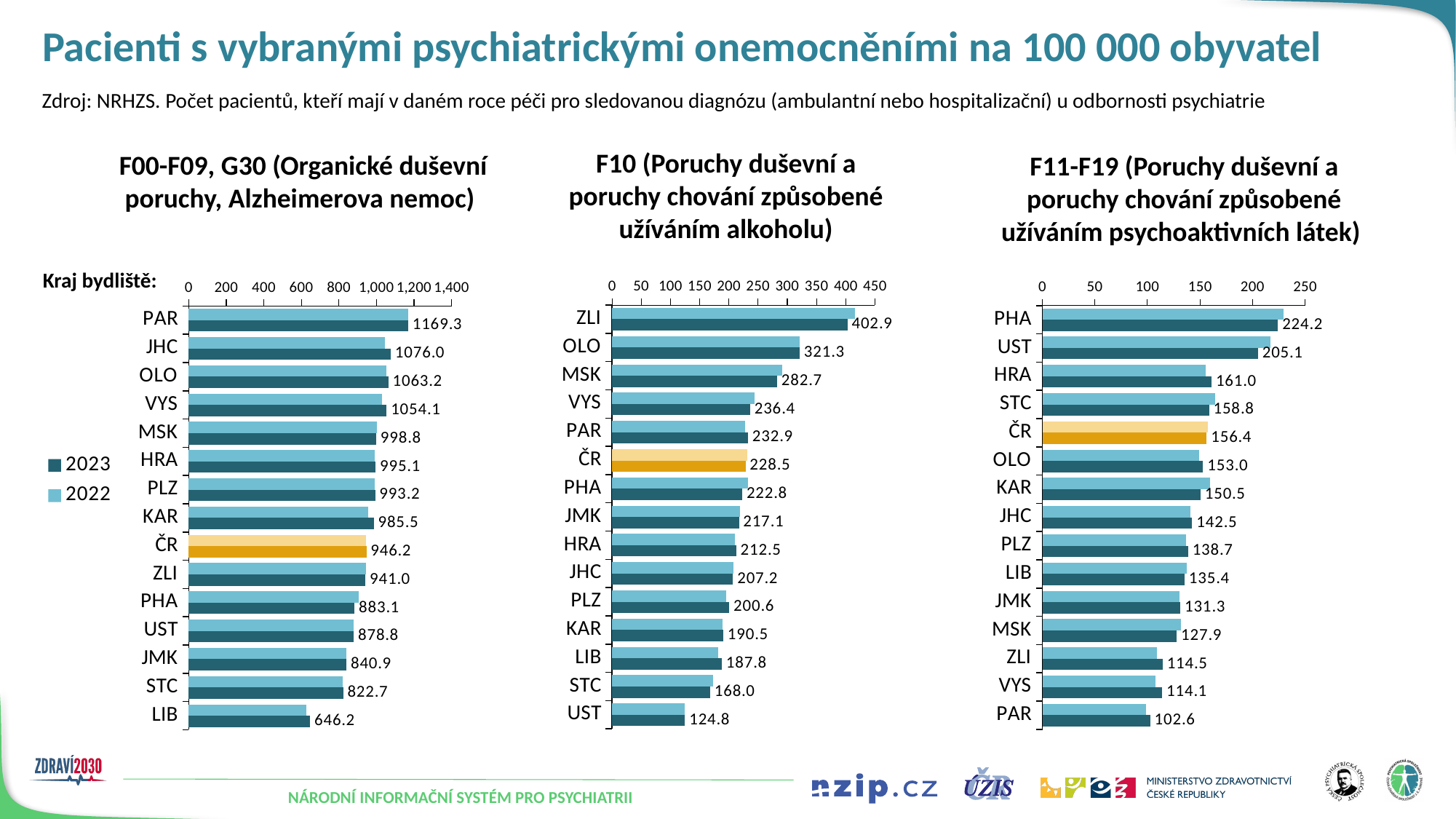
What type of chart is used for the F11-F19 data? bar chart In the F11-F19 chart, which region has the lowest 2023 value? PAR In the F10 chart, which region has the highest 2023 value? ZLI In the F00-F09, G30 chart, is the 2022 value for LIB greater or less than 800? less In the F11-F19 chart, what is the 2023 value for UST? 205.1 In the F10 chart, what is the difference between the 2023 values for ZLI and OLO? 81.6 In the F00-F09, G30 chart, what is the 2023 value for PAR? 1169.3 In the F00-F09, G30 chart, which region has the lowest 2023 value? LIB In the F11-F19 chart, which has the larger 2023 value, PHA or HRA? PHA How many series does the legend list? 2 How many regions are listed in the F10 chart? 15 In the F10 chart, what is the 2023 value for ČR? 228.5